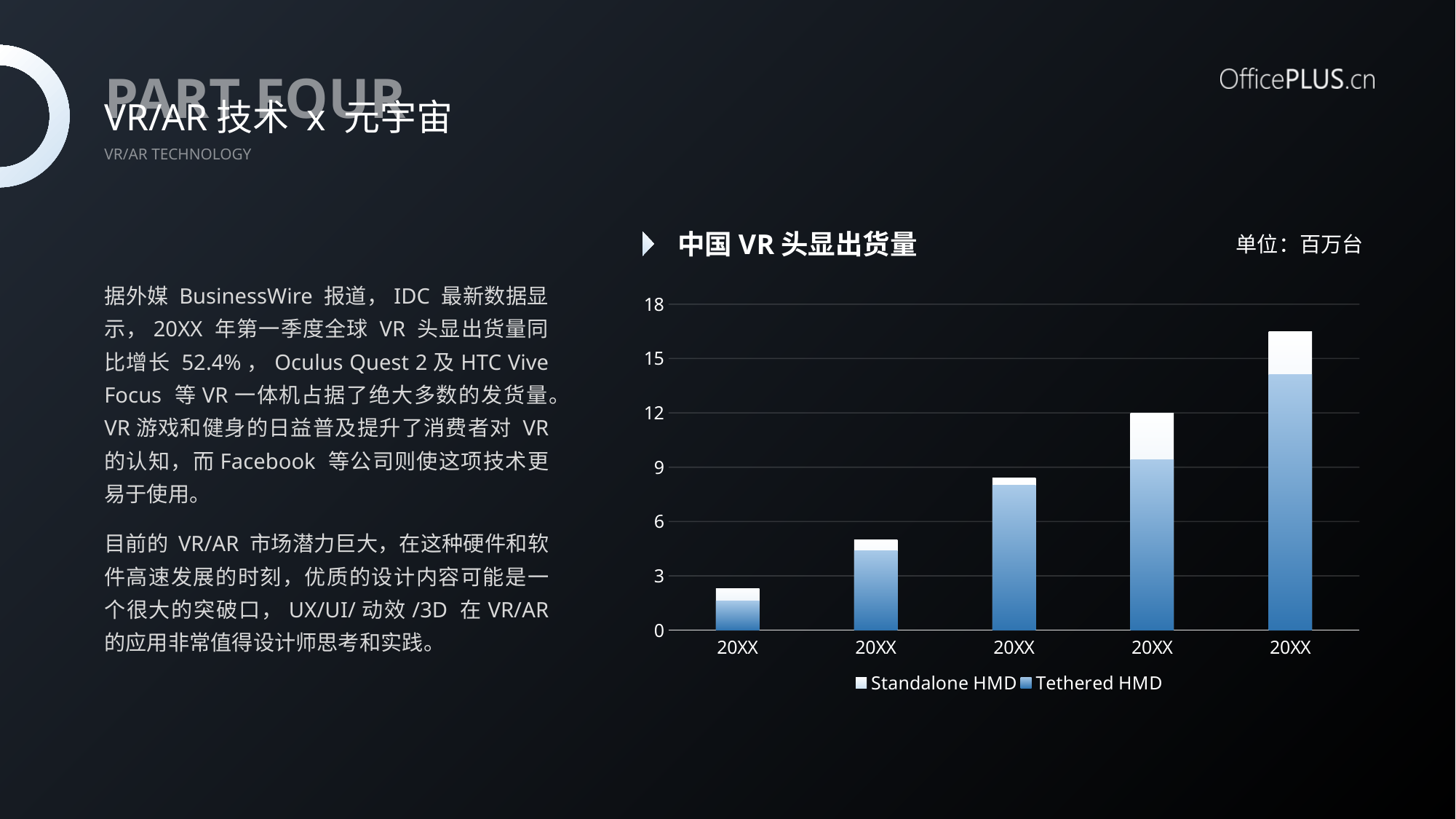
What kind of chart is shown on the slide? bar chart How many series does the legend of the chart list? 2 Is the total value of the rightmost bar greater or less than 15? greater What is the title of the chart? 中国 VR 头显出货量 Is the total value of the leftmost bar greater or less than 3? less Which bar has the lowest total value in the chart? the first (leftmost) bar Which is larger, the total of the fourth bar or the total of the third bar? the fourth bar How many bars (categories) are plotted in the chart? 5 Is the total value of the third bar greater or less than 6? greater Which bar has the highest total value in the chart? the fifth (rightmost) bar Do the total bar heights rise or fall from left to right along the x axis? rise What unit is stated for the chart's values? 百万台